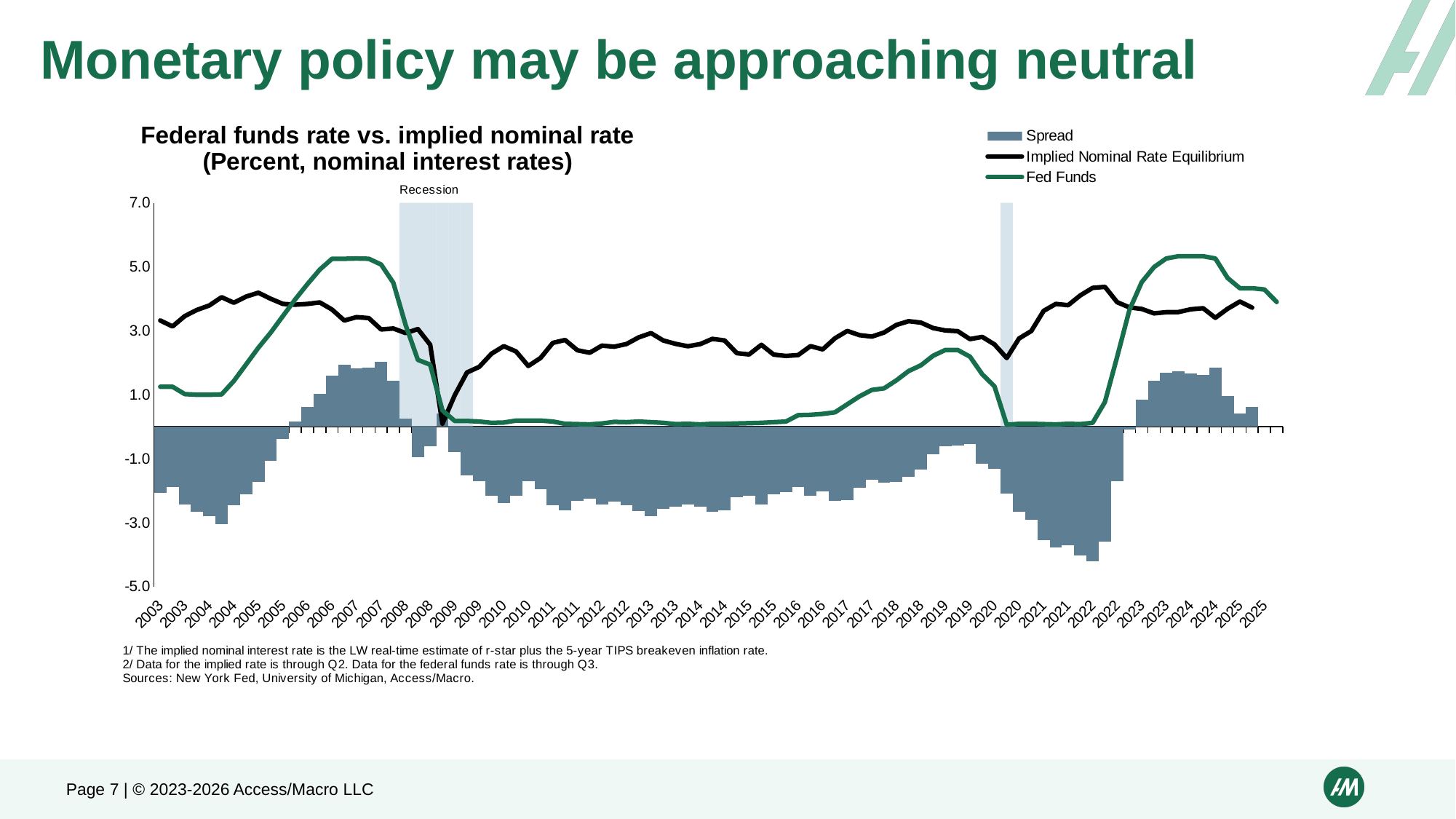
What do the light blue shaded areas on the chart indicate? Recession In 2010, which is higher: Fed Funds or Implied Nominal Rate Equilibrium? Implied Nominal Rate Equilibrium Is the Fed Funds value in 2010 greater or less than 1.0? less What is the title of the chart? Federal funds rate vs. implied nominal rate (Percent, nominal interest rates) Is the Implied Nominal Rate Equilibrium value in 2022 greater or less than 3.0? greater Does the Fed Funds line rise or fall from 2022 to 2024? rise Does the Fed Funds line rise or fall from 2007 to 2009? fall Is the Fed Funds value in 2015 greater or less than 1.0? less What kind of chart is this? A combination chart with bars and lines How many series does the legend list? 3